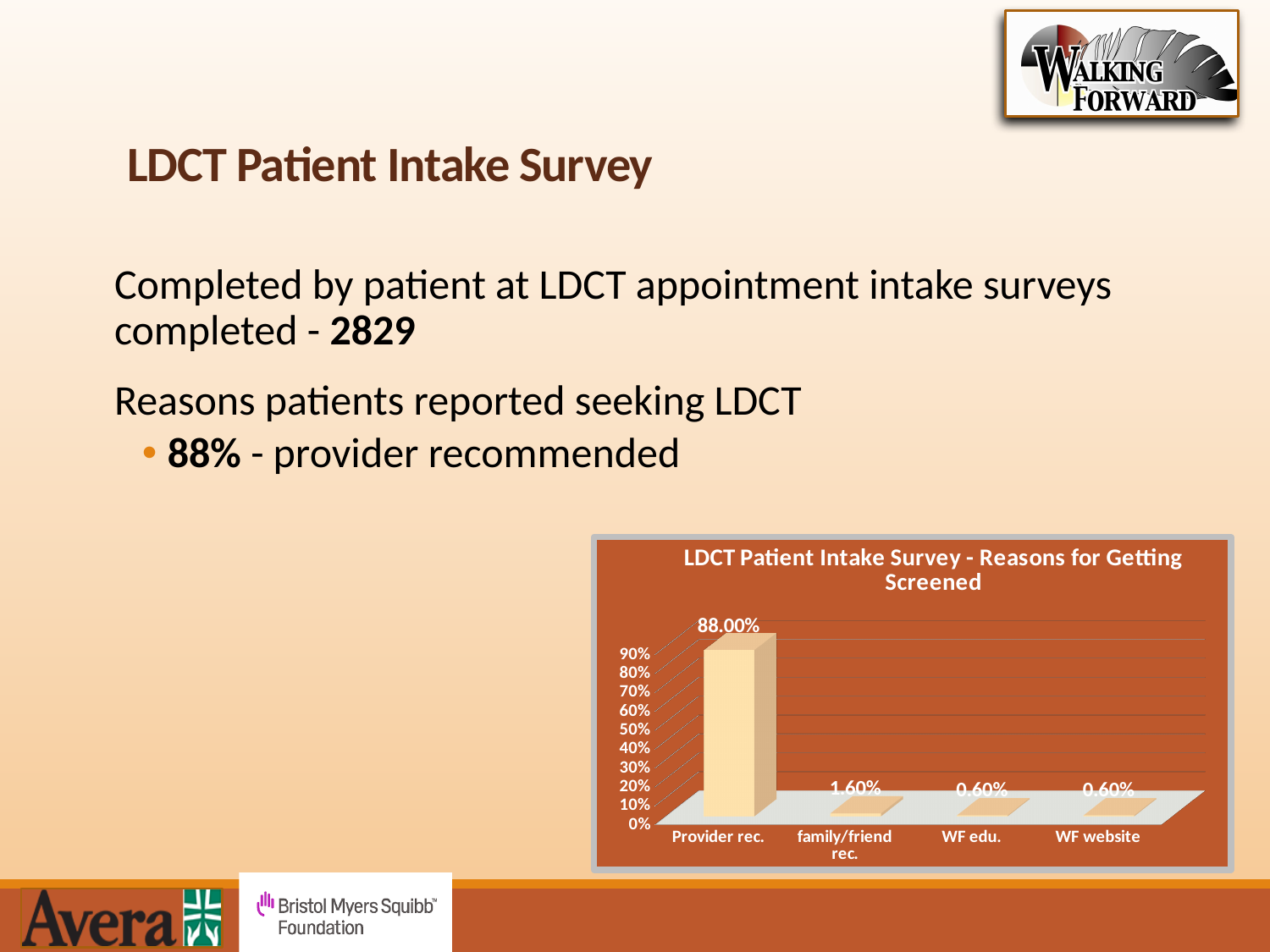
What kind of chart is shown? bar chart How many categories are shown on the x axis? 4 Is the value for Provider rec. greater or less than 50%? greater What is the value for WF edu.? 0.60% What is the value for WF website? 0.60% What is the title of the chart? LDCT Patient Intake Survey - Reasons for Getting Screened Which category has the highest value? Provider rec. What is the value for Provider rec.? 88.00% What is the difference between the values for Provider rec. and family/friend rec.? 86.40% What is the value for family/friend rec.? 1.60% Which is larger, the value for family/friend rec. or the value for WF edu.? family/friend rec. Do the values rise or fall from left to right along the x axis? fall